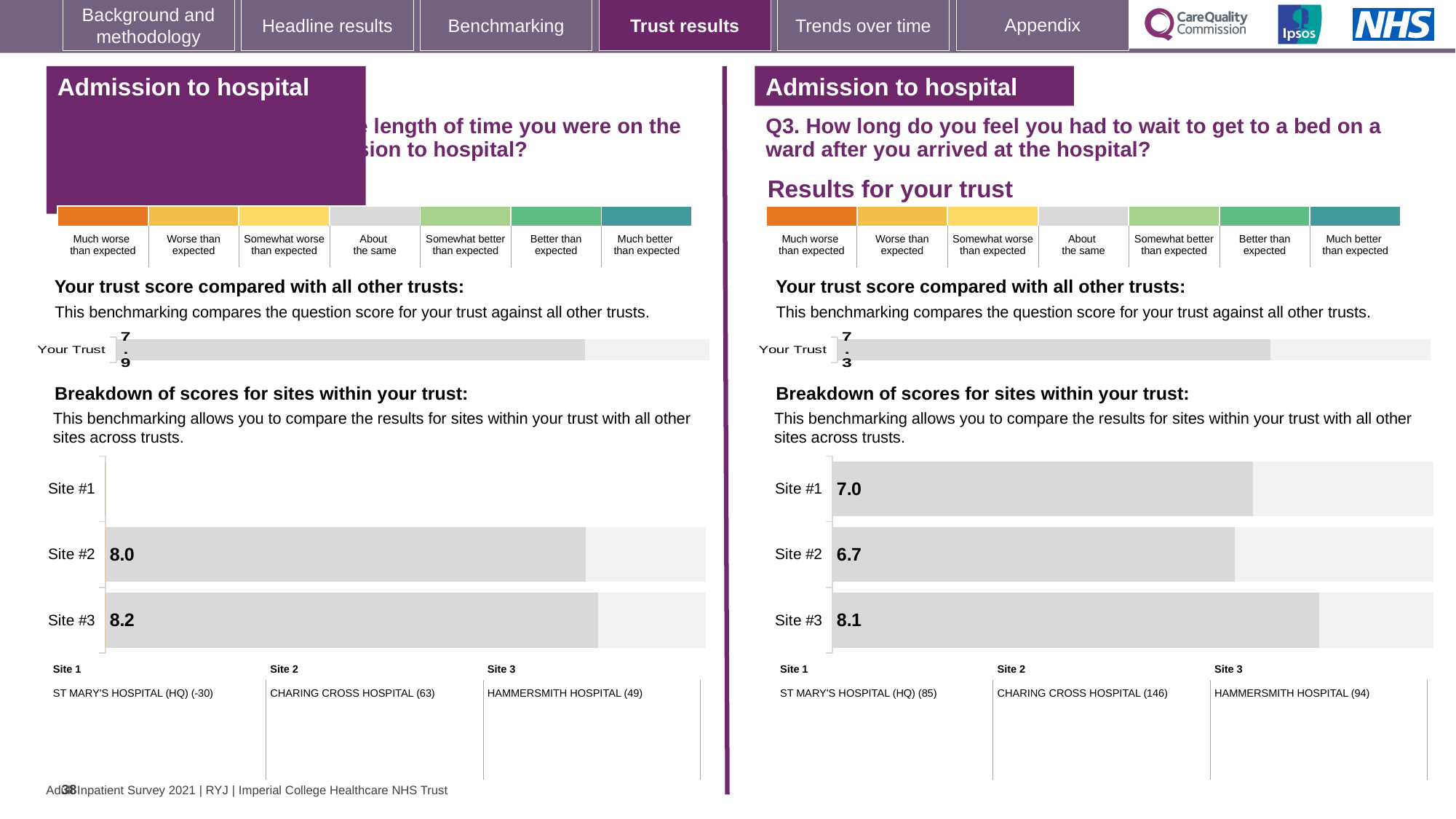
On the left-hand slide, what is the score shown for Site #3 in the breakdown of scores for sites chart? 8.2 On the right-hand slide (Q3), what is the score shown for Site #2 in the breakdown of scores for sites chart? 6.7 On the right-hand slide (Q3), which site has the lowest score in the breakdown of scores for sites chart? Site #2 On the left-hand slide, what is the score shown for Site #2 in the breakdown of scores for sites chart? 8.0 On the right-hand slide (Q3), what is the difference between the Site #3 score and the Site #2 score in the breakdown chart? 1.4 On the left-hand slide, which has the larger score in the breakdown chart, Site #2 or Site #3? Site #3 On the right-hand slide (Q3), what is the score shown for Site #1 in the breakdown of scores for sites chart? 7.0 On the right-hand slide (Q3), which site has the highest score in the breakdown of scores for sites chart? Site #3 On the right-hand slide (Q3), what is the 'Your Trust' score shown in the trust score comparison chart? 7.3 What type of chart is used for the breakdown of scores for sites on the right-hand slide (Q3)? Bar chart On the right-hand slide (Q3), what is the score shown for Site #3 in the breakdown of scores for sites chart? 8.1 On the left-hand slide, what is the 'Your Trust' score shown in the trust score comparison chart? 7.9